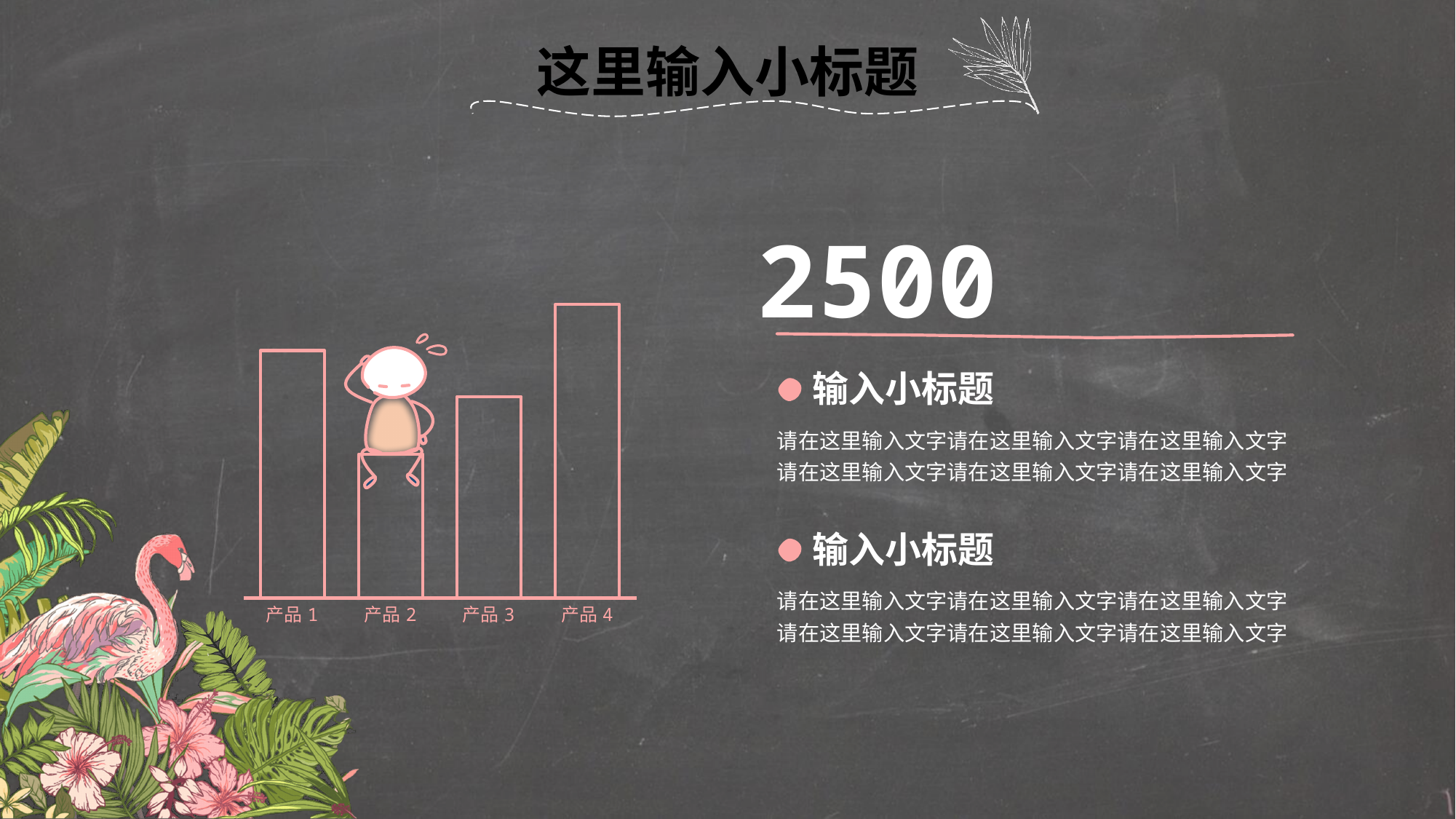
Which category has the tallest bar in the chart? 产品 4 What kind of chart is shown on the slide? bar chart What is the label of the first category on the x axis of the chart? 产品 1 Which bar is taller, 产品 3 or 产品 2? 产品 3 Which category has the shortest bar in the chart? 产品 2 How many categories does the bar chart show? 4 What colour are the bar outlines in the chart? pink Which bar is taller, 产品 4 or 产品 2? 产品 4 Which bar is taller, 产品 4 or 产品 1? 产品 4